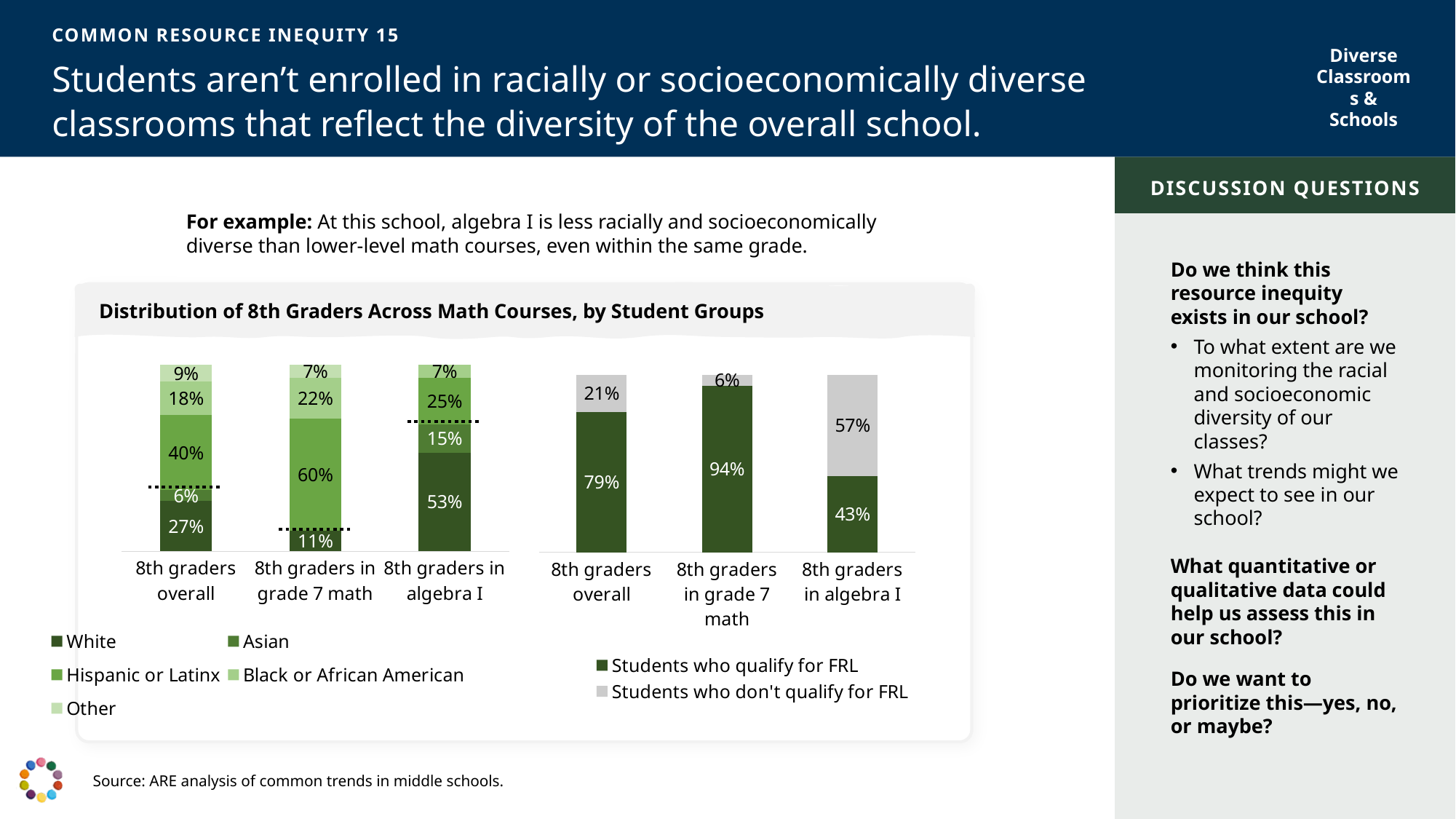
In the left chart (student racial groups), what percentage of 8th graders overall are White? 27% In the left chart (student racial groups), what percentage of 8th graders in algebra I are White? 53% In the right chart (FRL), what percentage of 8th graders in grade 7 math qualify for FRL? 94% In the left chart (student racial groups), what percentage of 8th graders in grade 7 math are Hispanic or Latinx? 60% What type of chart is the right chart (FRL)? Stacked bar chart In the right chart (FRL), which course group has the lowest share of students who qualify for FRL? 8th graders in algebra I What is the title shown above the charts? Distribution of 8th Graders Across Math Courses, by Student Groups In the right chart (FRL), what percentage of 8th graders in algebra I don't qualify for FRL? 57% In the left chart (student racial groups), which is larger: the White share of 8th graders in algebra I or the White share of 8th graders in grade 7 math? 8th graders in algebra I How many series does the legend of the left chart (student racial groups) list? 5 In the left chart (student racial groups), what percentage of 8th graders in algebra I are Asian? 15% In the right chart (FRL), what is the difference between the share of students who qualify for FRL in grade 7 math and in algebra I? 51%